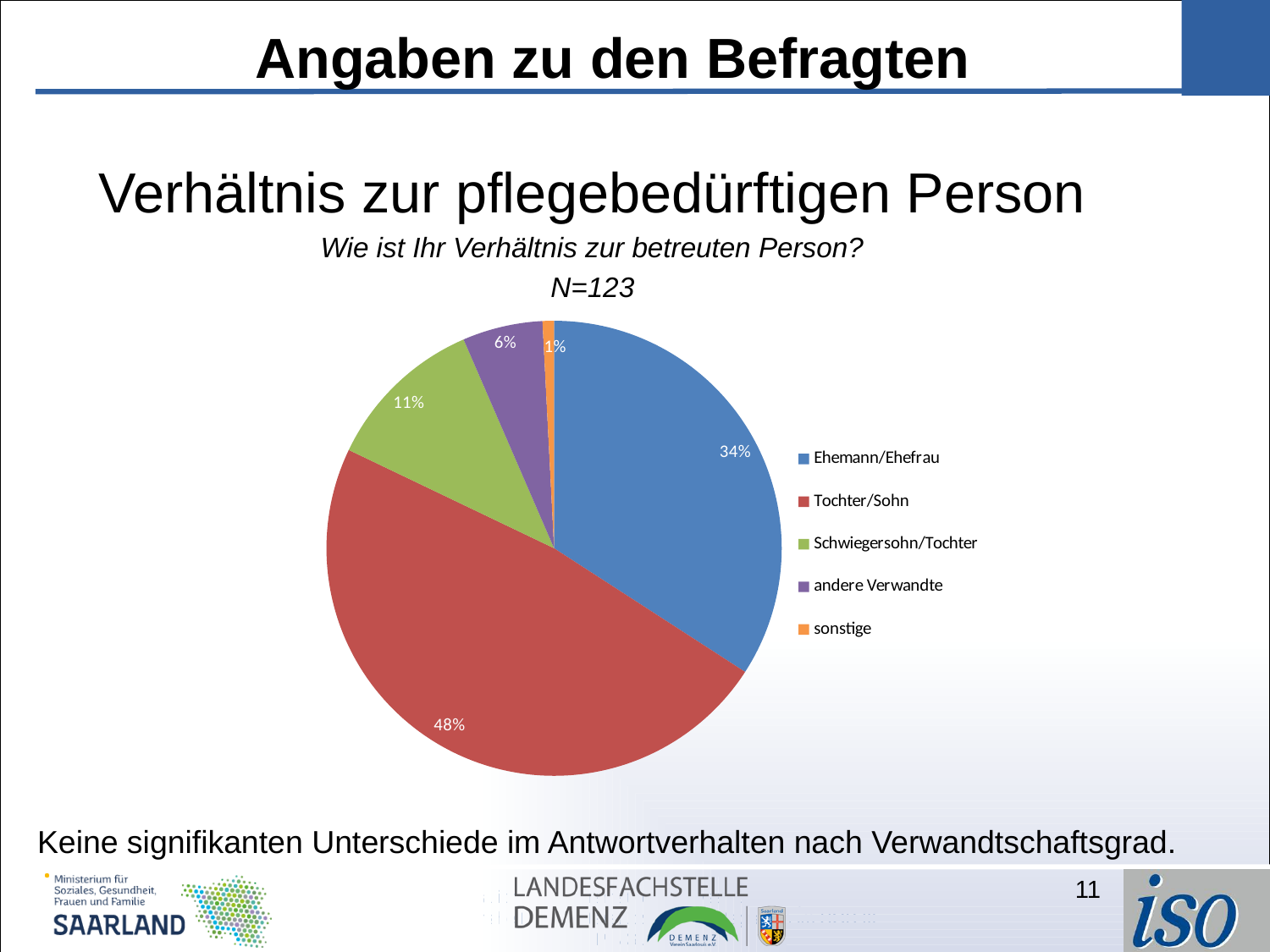
What kind of chart is shown on the slide? pie chart Which category has the smallest slice of the pie? sonstige Which category has the largest slice of the pie? Tochter/Sohn What share of the pie does Schwiegersohn/Tochter have? 11% What share of the pie does Tochter/Sohn have? 48% How many categories does the legend list? 5 What is the difference in percentage points between Tochter/Sohn and Ehemann/Ehefrau? 14 Which is larger, the share for Schwiegersohn/Tochter or the share for andere Verwandte? Schwiegersohn/Tochter What share of the pie does Ehemann/Ehefrau have? 34% What share of the pie does andere Verwandte have? 6% What share of the pie does sonstige have? 1% What is the sample size (N) stated above the chart? N=123